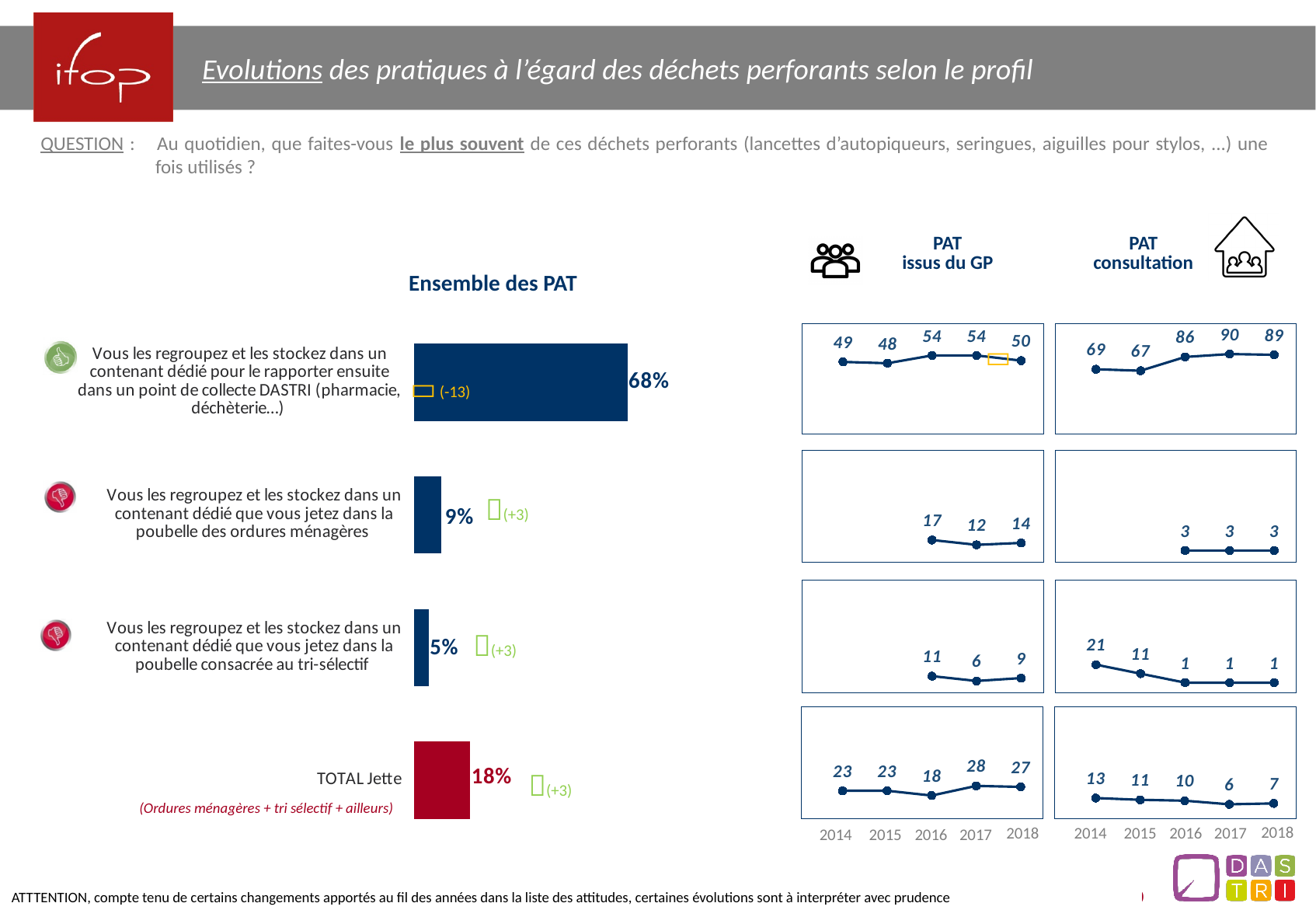
In the third-row 'PAT consultation' line chart, is the 2014 value larger or smaller than the 2015 value? larger In the 'Ensemble des PAT' bar chart, what is the value for 'TOTAL Jette'? 18% In the top 'PAT consultation' line chart, what is the value for 2017? 90 In the 'Ensemble des PAT' bar chart, what is the value for regrouping and storing in a dedicated container to bring to a DASTRI collection point? 68% In the 'Ensemble des PAT' bar chart, what is the difference between the value for the ordures ménagères category and the tri-sélectif category? 4% In the 'Ensemble des PAT' bar chart, how many bars are shown? 4 In the 'Ensemble des PAT' bar chart, which category has the lowest value? Vous les regroupez et les stockez dans un contenant dédié que vous jetez dans la poubelle consacrée au tri-sélectif In the top 'PAT consultation' line chart, what is the difference between the 2014 and 2018 values? 20 In the top 'PAT issus du GP' line chart, what is the value for 2018? 50 In the bottom 'PAT issus du GP' line chart (TOTAL Jette row), which year has the highest value? 2017 In the bottom 'PAT consultation' line chart (TOTAL Jette row), do the values rise or fall from 2014 to 2018? fall What kind of chart is 'Ensemble des PAT'? bar chart